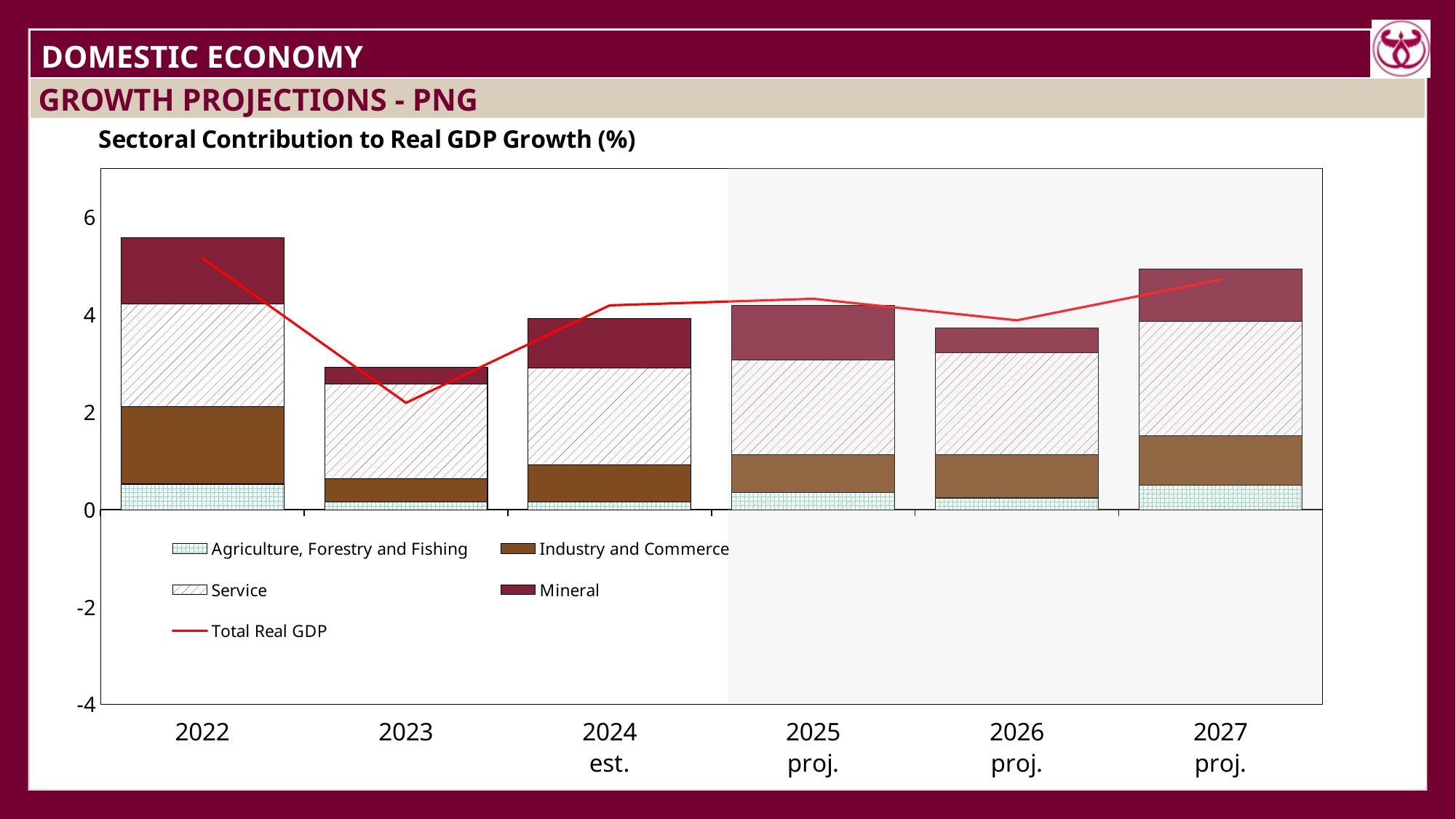
Which year has the shortest stacked bar? 2023 Is the total stacked bar for 2023 greater or less than 4? less What is the title of the chart? Sectoral Contribution to Real GDP Growth (%) Which year has the tallest stacked bar? 2022 How many series does the legend list? 5 Does the Total Real GDP line rise or fall from 2022 to 2023? Fall Which stacked bar is taller, 2022 or 2023? 2022 Is the total stacked bar for 2022 greater or less than 4? greater How many years (categories) are shown on the x axis? 6 What kind of chart is shown on the slide? Stacked bar chart with a line Is the total stacked bar for 2026 proj. greater or less than 4? less